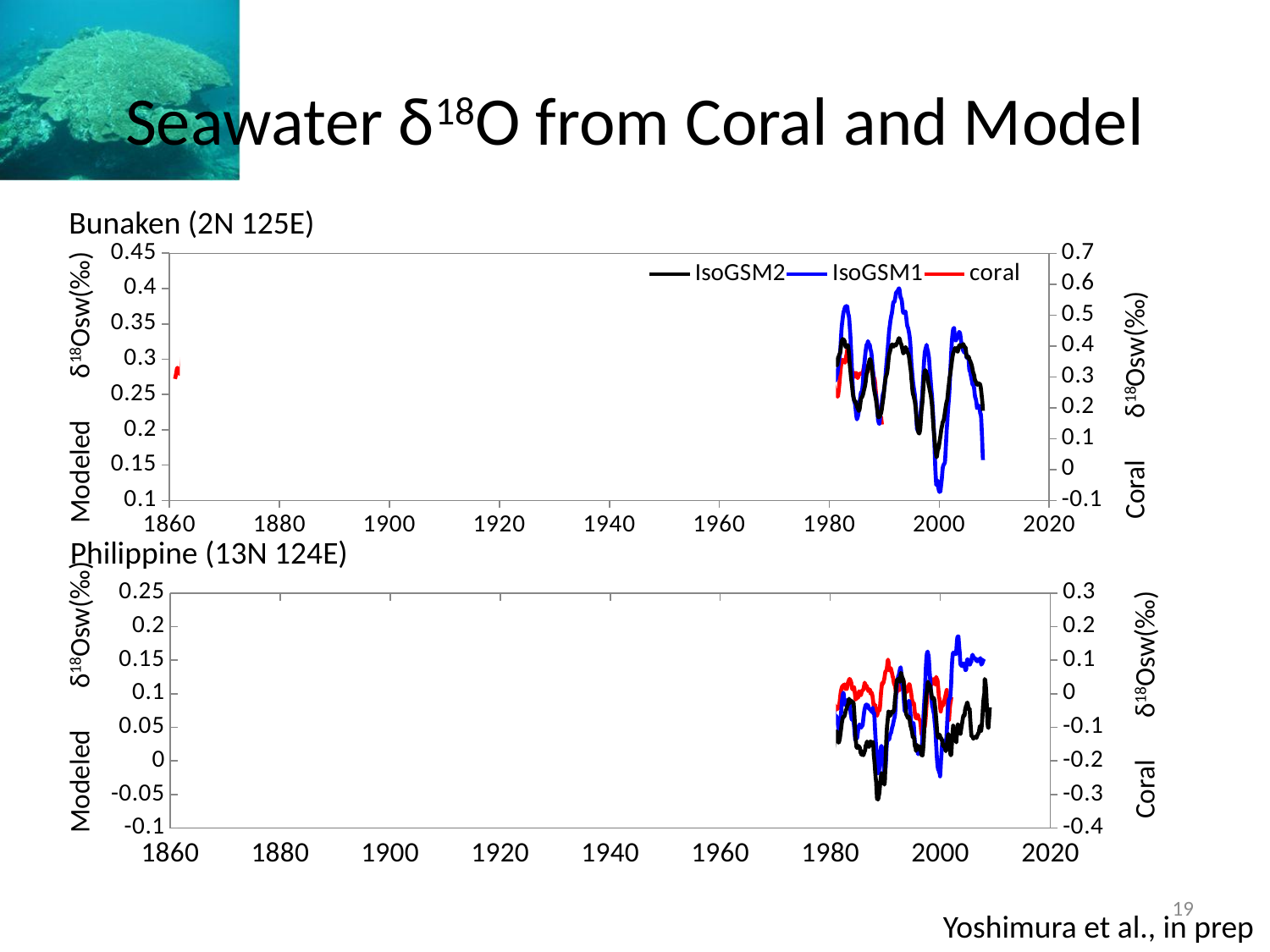
On the Philippine (13N 124E) chart, is the lowest value of IsoGSM2 around 1988 on the left axis greater or less than 0? less On the Bunaken (2N 125E) chart, is the peak value of IsoGSM1 around 1992 on the left axis greater or less than 0.35? greater What kind of chart is the bottom chart, Philippine (13N 124E)? line chart On the Philippine (13N 124E) chart, is the highest value of IsoGSM1 after 2000 on the left axis greater or less than 0.15? greater On the Bunaken (2N 125E) chart, is the IsoGSM1 value around 1992 greater or less than the IsoGSM1 value around 2000? greater On the Bunaken (2N 125E) chart, which series is drawn in red? coral What kind of chart is the top chart, Bunaken (2N 125E)? line chart How many series does the legend on the Bunaken (2N 125E) chart list? 3 On the Bunaken (2N 125E) chart, which series is drawn in blue? IsoGSM1